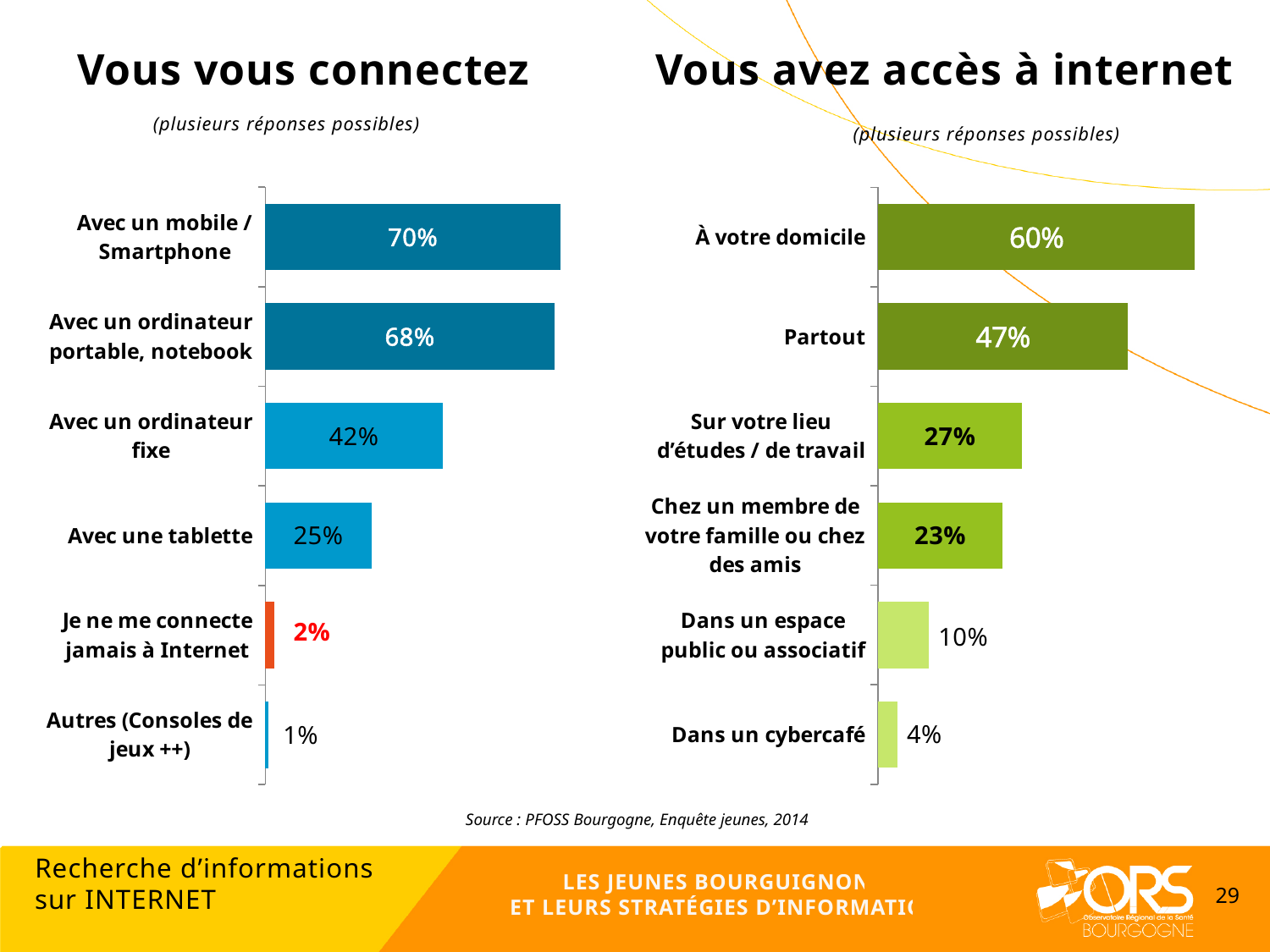
In the 'Vous avez accès à internet' chart, which category has the highest value? À votre domicile What type of chart is the 'Vous avez accès à internet' chart? Bar chart In the 'Vous vous connectez' chart, which bar is coloured orange-red? Je ne me connecte jamais à Internet In the 'Vous avez accès à internet' chart, what is the value for 'Partout'? 47% In the 'Vous avez accès à internet' chart, what is the difference between 'À votre domicile' and 'Dans un cybercafé'? 56% In the 'Vous vous connectez' chart, what is the difference between 'Avec un ordinateur portable, notebook' and 'Avec un ordinateur fixe'? 26% In the 'Vous avez accès à internet' chart, what is the value for 'Dans un espace public ou associatif'? 10% In the 'Vous vous connectez' chart, how many categories are shown? 6 In the 'Vous avez accès à internet' chart, which is larger: 'Sur votre lieu d'études / de travail' or 'Chez un membre de votre famille ou chez des amis'? Sur votre lieu d'études / de travail In the 'Vous vous connectez' chart, which category has the lowest value? Autres (Consoles de jeux ++) In the 'Vous vous connectez' chart, what is the value for 'Avec un mobile / Smartphone'? 70% In the 'Vous vous connectez' chart, what is the value for 'Avec une tablette'? 25%